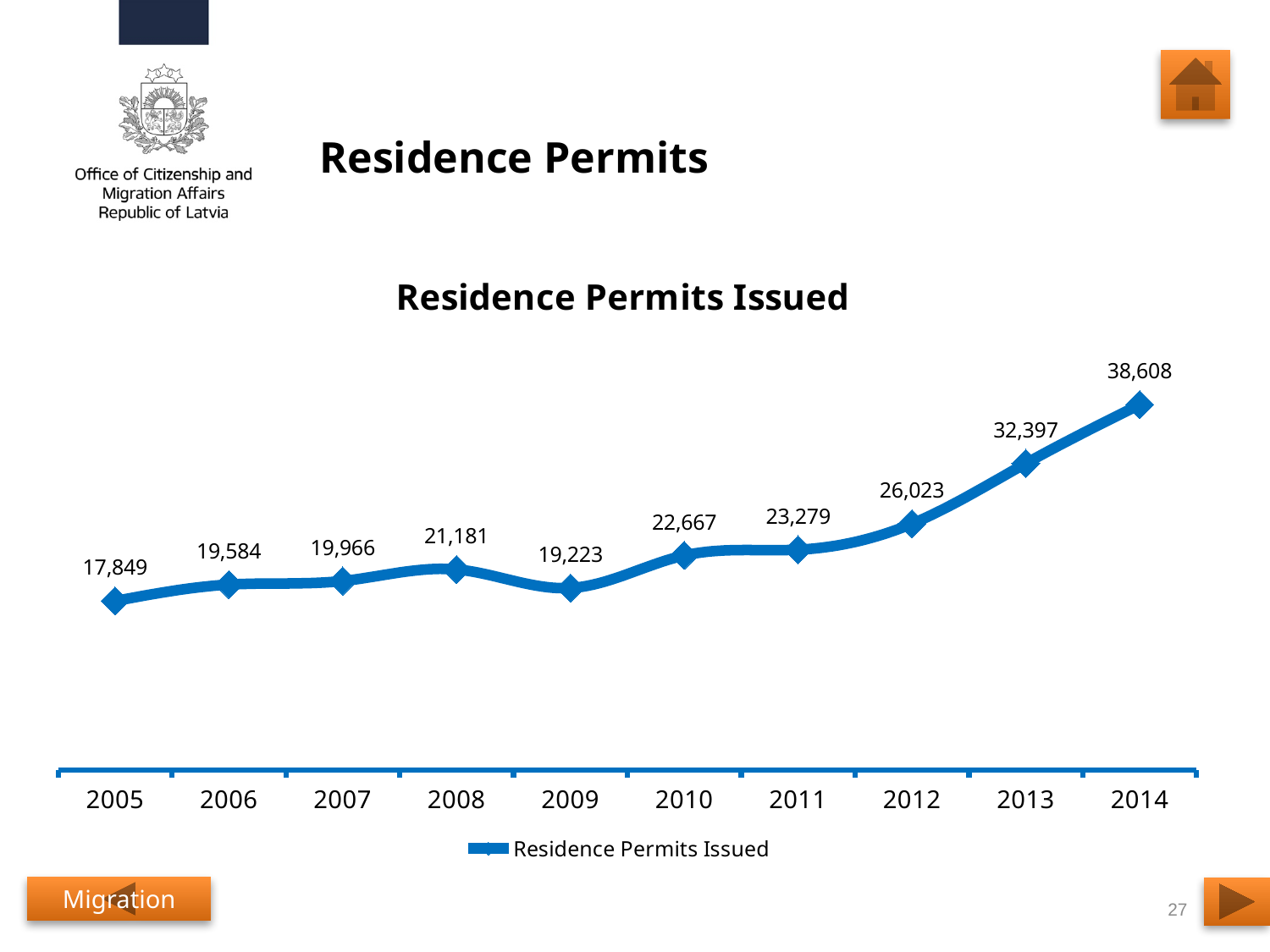
How many series does the legend list? 1 How many years are plotted on the x axis? 10 What is the value for 2009 in the Residence Permits Issued chart? 19,223 Which year has the lowest number of residence permits issued? 2005 What is the difference between the values for 2014 and 2013? 6,211 Which year has a larger value, 2010 or 2011? 2011 How many residence permits were issued in 2012? 26,023 What is the title of the chart? Residence Permits Issued What is the difference between the values for 2008 and 2009? 1,958 Do the values generally rise or fall from 2009 to 2014? Rise Which year has the highest number of residence permits issued? 2014 What kind of chart is shown on the slide? Line chart